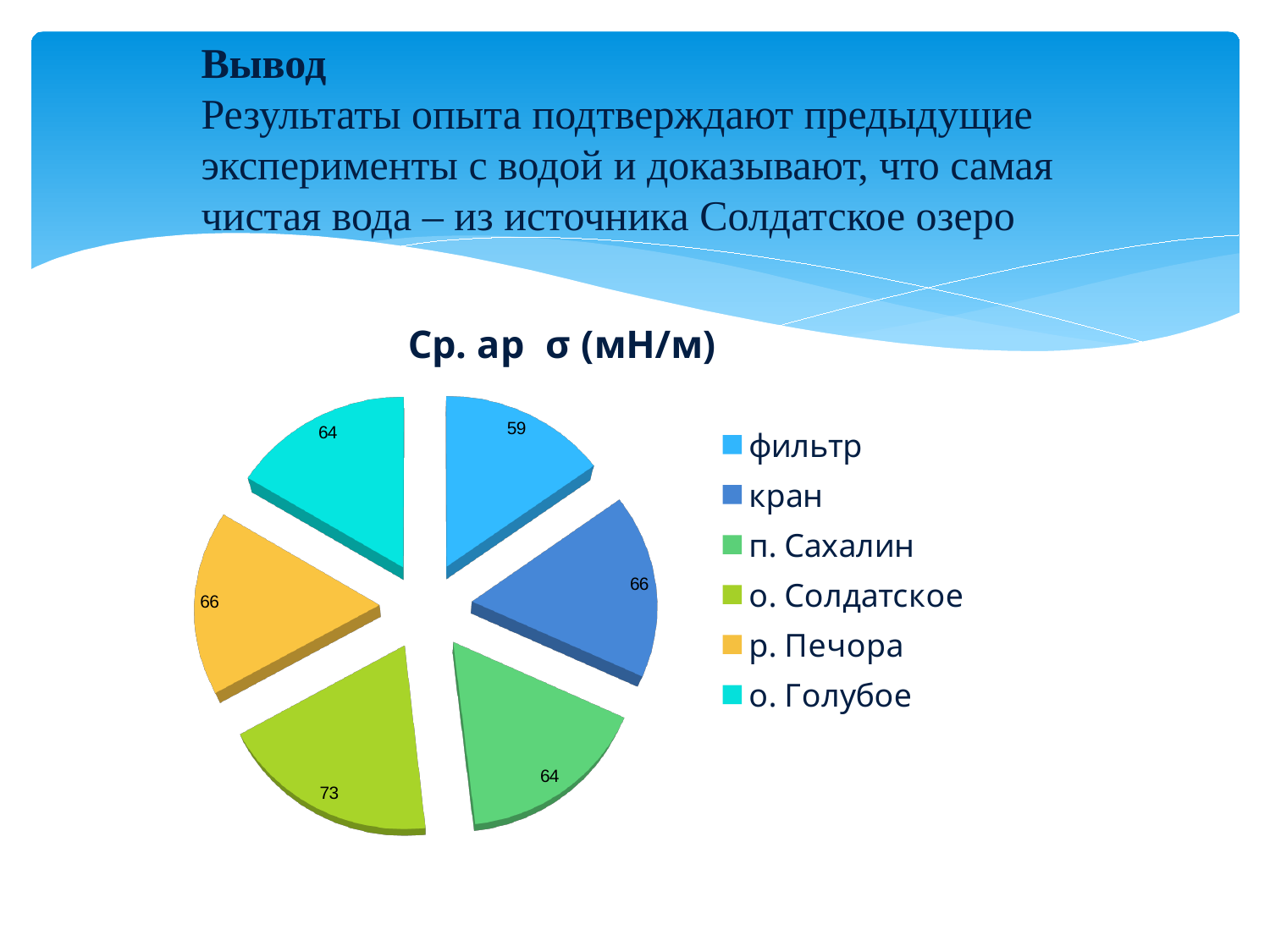
What kind of chart is shown on the slide? pie chart How many categories are shown in the pie chart? 6 What is the title of the chart? Ср. ар σ (мН/м) What is the value for о. Солдатское in the pie chart? 73 Which category has the lowest value in the pie chart? фильтр Which category has the highest value in the pie chart? о. Солдатское Which category is shown in the cyan slice of the pie chart? о. Голубое What is the value for фильтр in the pie chart? 59 What is the value for р. Печора in the pie chart? 66 What is the value for п. Сахалин in the pie chart? 64 What is the difference between the values for о. Солдатское and фильтр? 14 Which has a larger value, кран or фильтр? кран